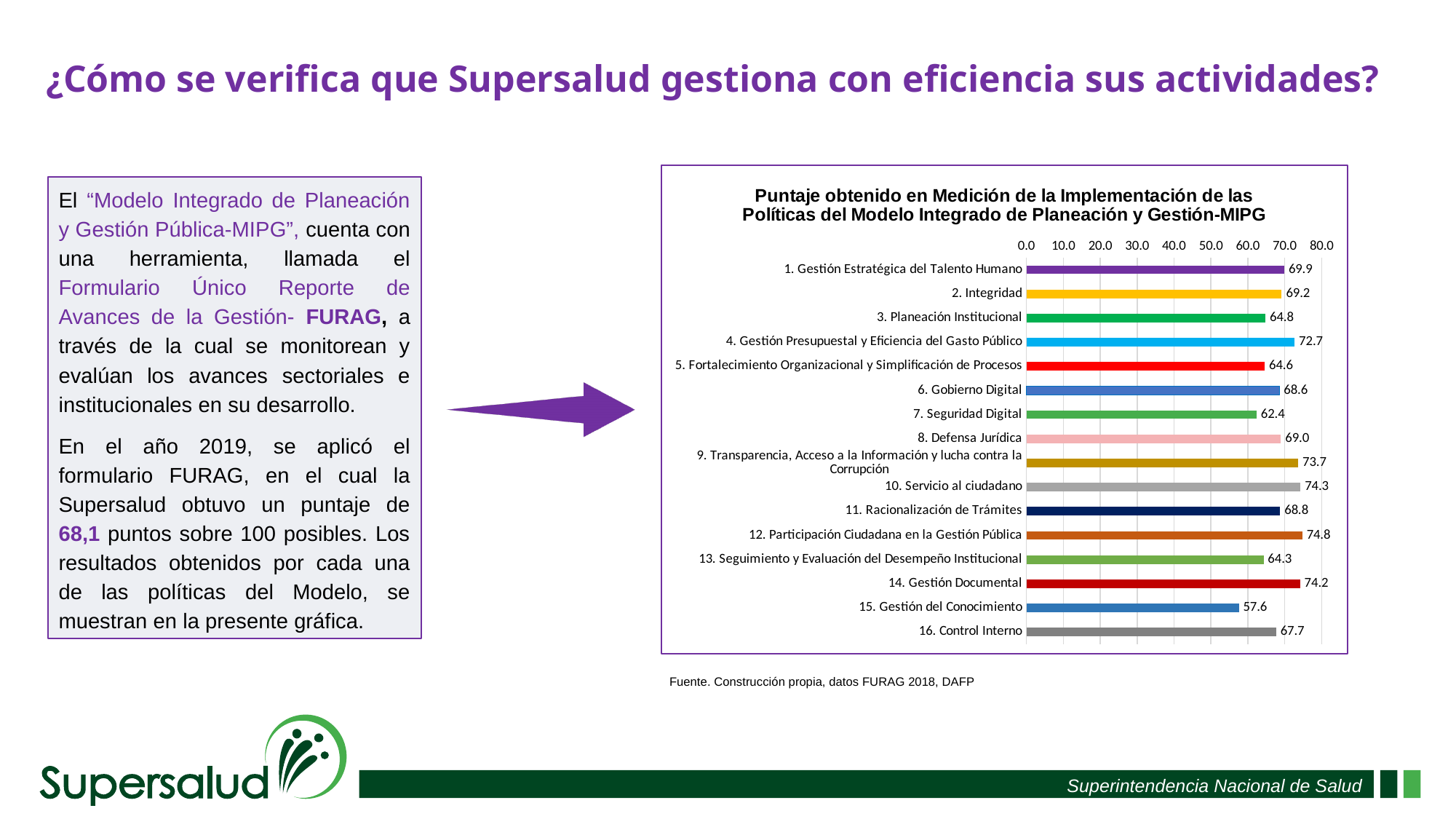
Which is larger, the value for 2. Integridad or the value for 6. Gobierno Digital? 2. Integridad What is the difference between the values for 12. Participación Ciudadana en la Gestión Pública and 15. Gestión del Conocimiento? 17.2 What is the maximum value shown on the chart's axis? 80.0 What is the value for 15. Gestión del Conocimiento? 57.6 What is the value for 4. Gestión Presupuestal y Eficiencia del Gasto Público? 72.7 What is the difference between the values for 10. Servicio al ciudadano and 7. Seguridad Digital? 11.9 What kind of chart is shown on the slide? bar chart Is the value for 16. Control Interno greater or less than 70.0? less Which category has the lowest value? 15. Gestión del Conocimiento What is the value for 8. Defensa Jurídica? 69.0 How many categories are shown in the chart? 16 Which category has the highest value? 12. Participación Ciudadana en la Gestión Pública